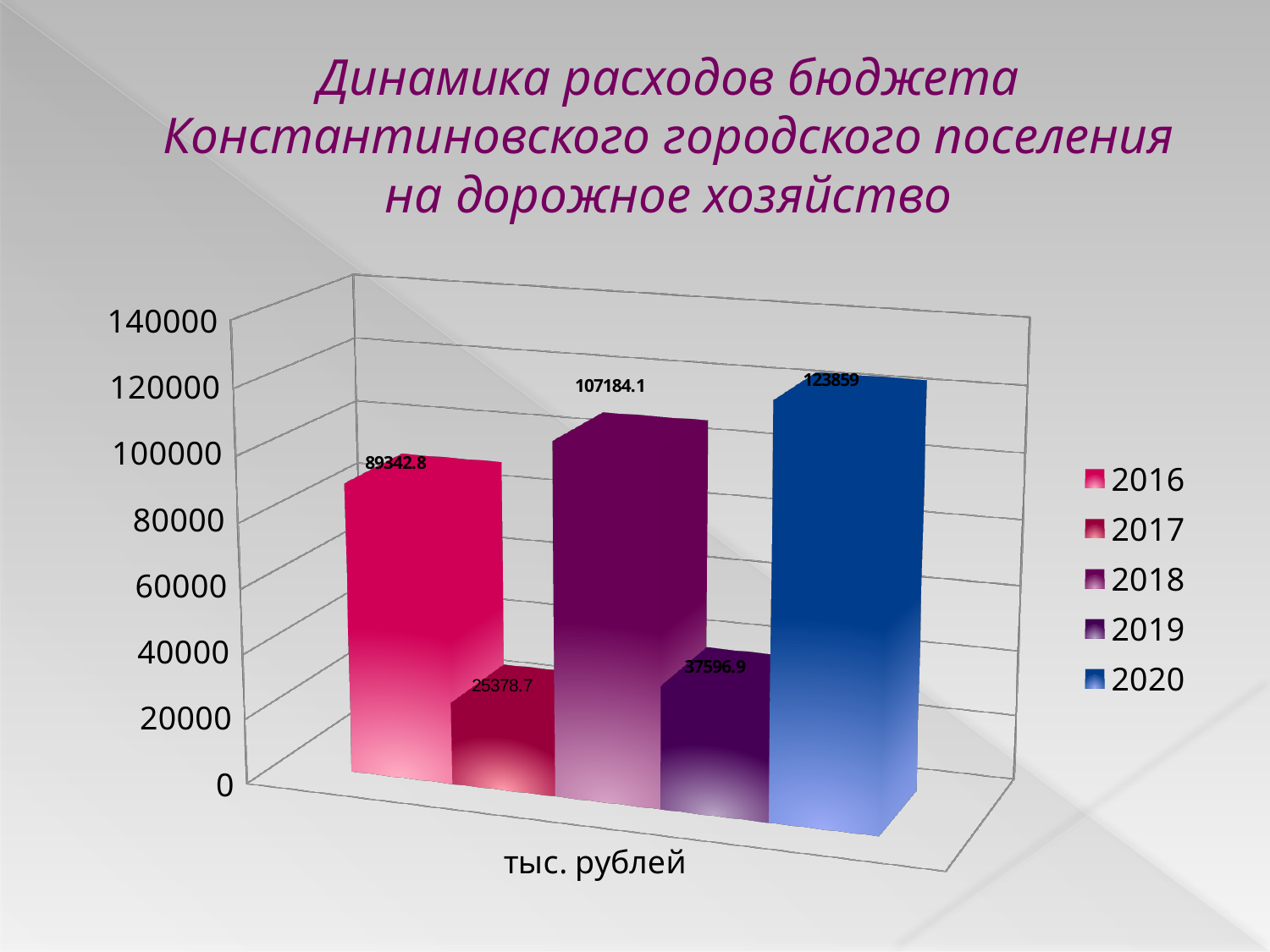
What kind of chart is shown on the slide? bar chart Which is larger, the value for 2019 or the value for 2017? 2019 What is the difference between the values for 2020 and 2018? 16674.9 Which year has the lowest value? 2017 What is the value for 2017? 25378.7 What is the value for 2016? 89342.8 Which year has the highest value? 2020 What is the difference between the values for 2016 and 2017? 63964.1 What is the value for 2020? 123859 How many series does the legend list? 5 What is the value for 2018? 107184.1 What is the value for 2019? 37596.9